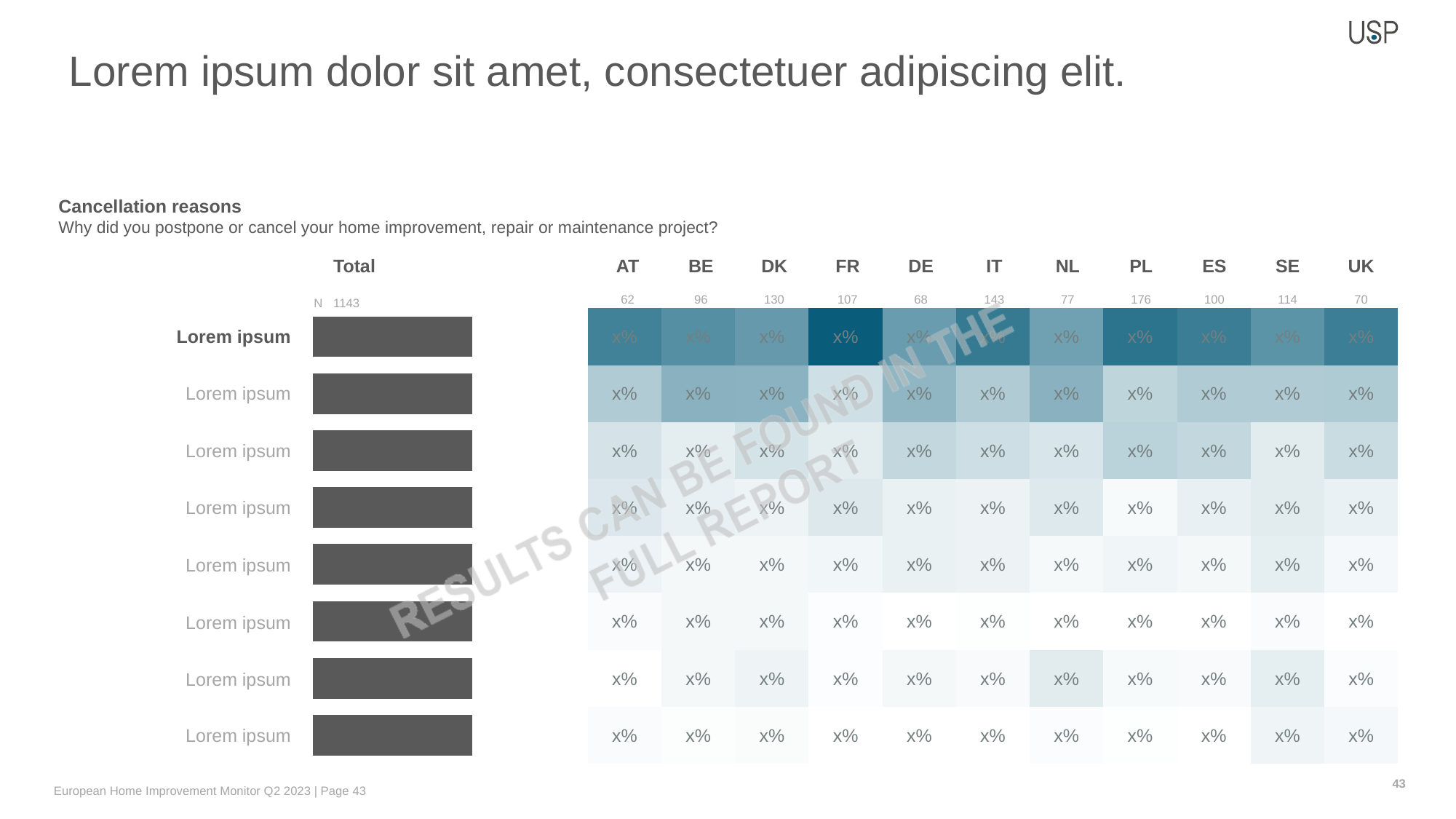
Which has a larger N, DK or FR? DK Which country column has the lowest N? AT How many country columns (excluding Total) does the chart show? 11 What is the N shown for AT? 62 What is the N shown for IT? 143 What kind of chart is shown in the Total column on the left? Bar chart What is the N shown for PL? 176 What is the difference between the N for PL and the N for AT? 114 Which country column has the highest N? PL What is the N (sample size) shown for the Total column? 1143 What is the title of the chart on the slide? Cancellation reasons How many cancellation-reason rows does the chart list? 8